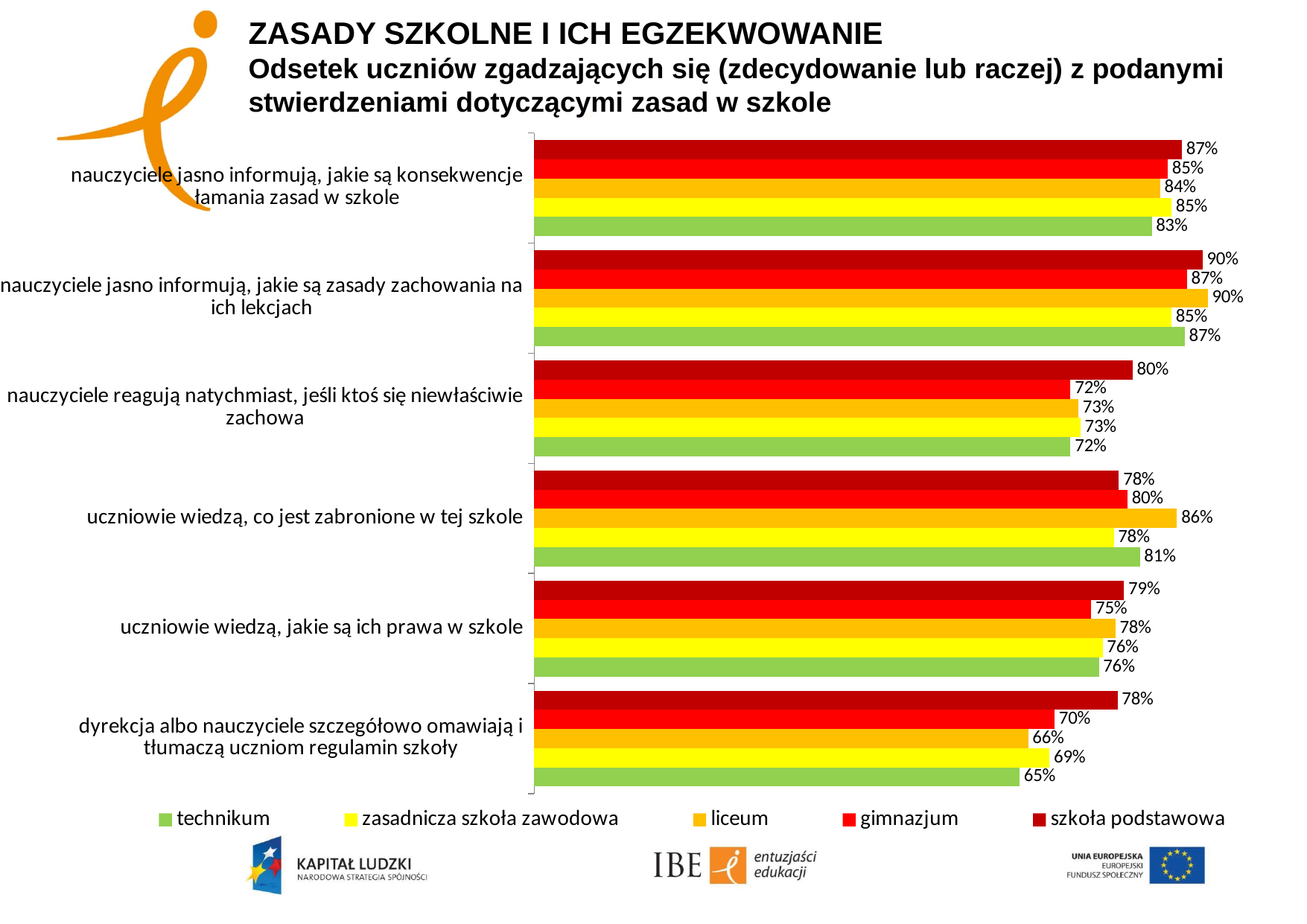
Which school type has the highest value for the statement "uczniowie wiedzą, co jest zabronione w tej szkole"? liceum What is the value for liceum for the statement "uczniowie wiedzą, co jest zabronione w tej szkole"? 86% Which colour represents gimnazjum in the legend? red What is the value for technikum for the statement "dyrekcja albo nauczyciele szczegółowo omawiają i tłumaczą uczniom regulamin szkoły"? 65% Which school type has the lowest value for the statement "dyrekcja albo nauczyciele szczegółowo omawiają i tłumaczą uczniom regulamin szkoły"? technikum What is the difference between szkoła podstawowa and technikum for the statement "dyrekcja albo nauczyciele szczegółowo omawiają i tłumaczą uczniom regulamin szkoły"? 13 percentage points What is the value for szkoła podstawowa for the statement "nauczyciele reagują natychmiast, jeśli ktoś się niewłaściwie zachowa"? 80% What is the difference between szkoła podstawowa and gimnazjum for the statement "nauczyciele reagują natychmiast, jeśli ktoś się niewłaściwie zachowa"? 8 percentage points How many statements (categories) are shown on the chart? 6 For the statement "uczniowie wiedzą, jakie są ich prawa w szkole", which is larger: the value for szkoła podstawowa or for gimnazjum? szkoła podstawowa How many series does the legend list? 5 What kind of chart is shown on the slide? bar chart